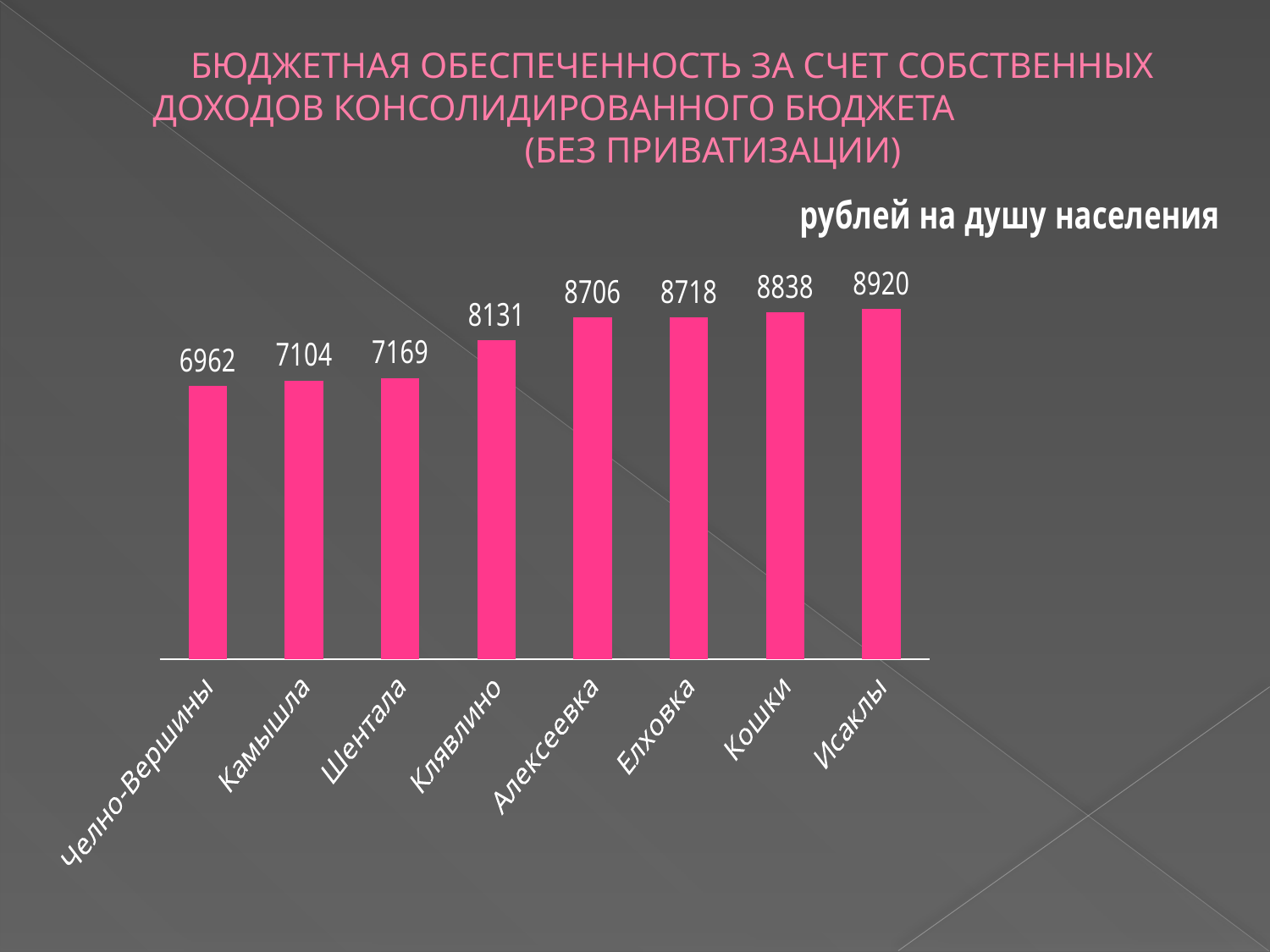
What unit is stated for the values on the chart? рублей на душу населения Do the values rise or fall from left to right along the x axis? Rise Which category has the highest value? Исаклы What kind of chart is shown on the slide? Bar chart How many categories are shown on the chart? 8 What is the difference between the values for Исаклы and Челно-Вершины? 1958 What is the value for Челно-Вершины? 6962 What is the value for Клявлино? 8131 What is the difference between the values for Кошки and Елховка? 120 Which is larger, the value for Шентала or the value for Камышла? Шентала What is the value for Исаклы? 8920 Which category has the lowest value? Челно-Вершины